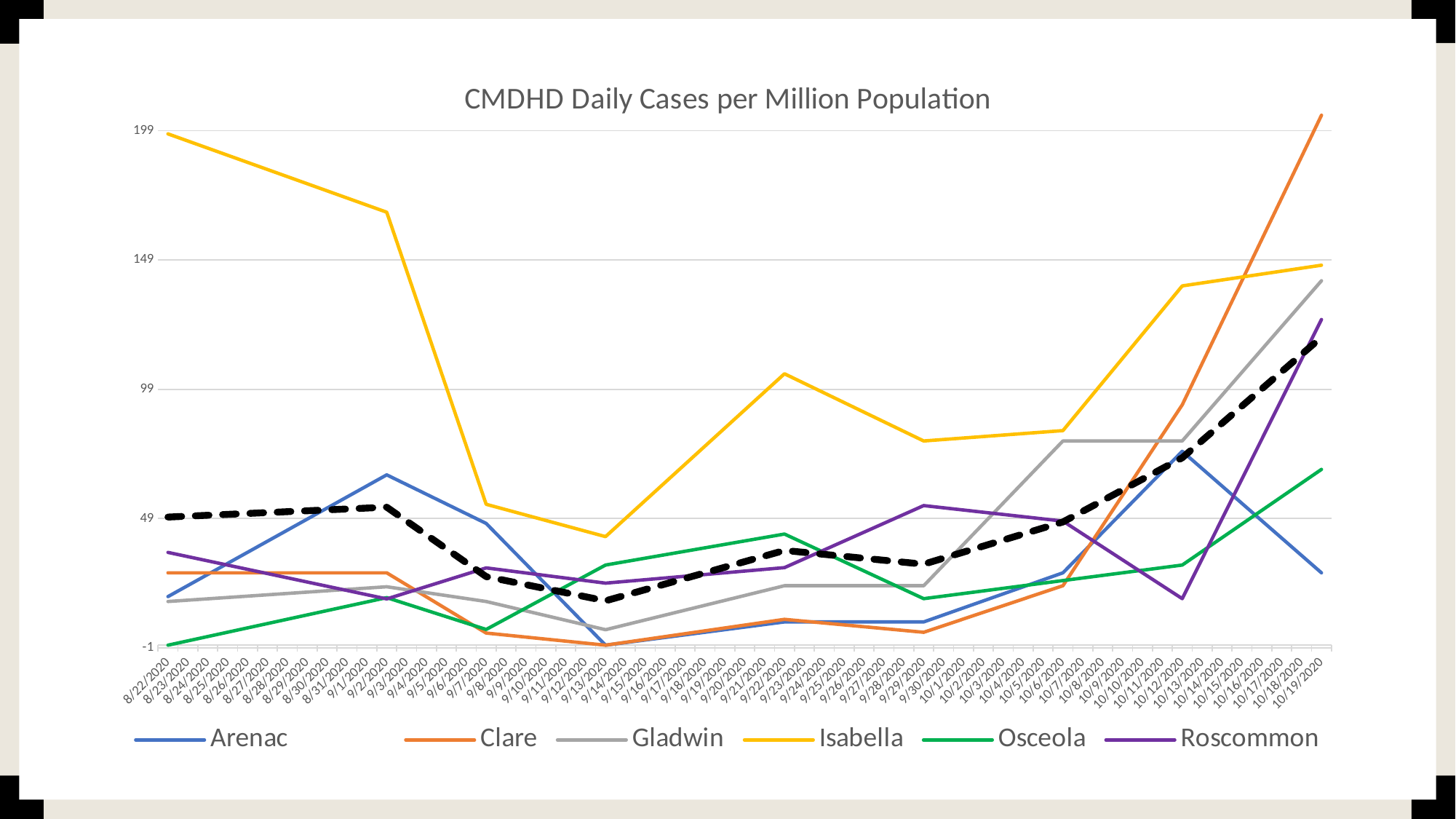
Which series has the lowest value on 10/19/2020? Arenac On 9/2/2020, which is larger: the value for Isabella or the value for Arenac? Isabella Which series has the highest value on 8/22/2020? Isabella What is the title of the chart? CMDHD Daily Cases per Million Population What kind of chart is shown on the slide? line chart Is the value for Roscommon on 10/19/2020 greater or less than 99? greater Which series has the lowest value on 8/22/2020? Osceola Is the value for Isabella on 9/29/2020 greater or less than 99? less How many series does the legend list? 6 Which series has the highest value on 10/19/2020? Clare Is the value for Isabella on 8/22/2020 greater or less than 149? greater Does the Isabella line rise or fall between 8/22/2020 and 9/13/2020? fall